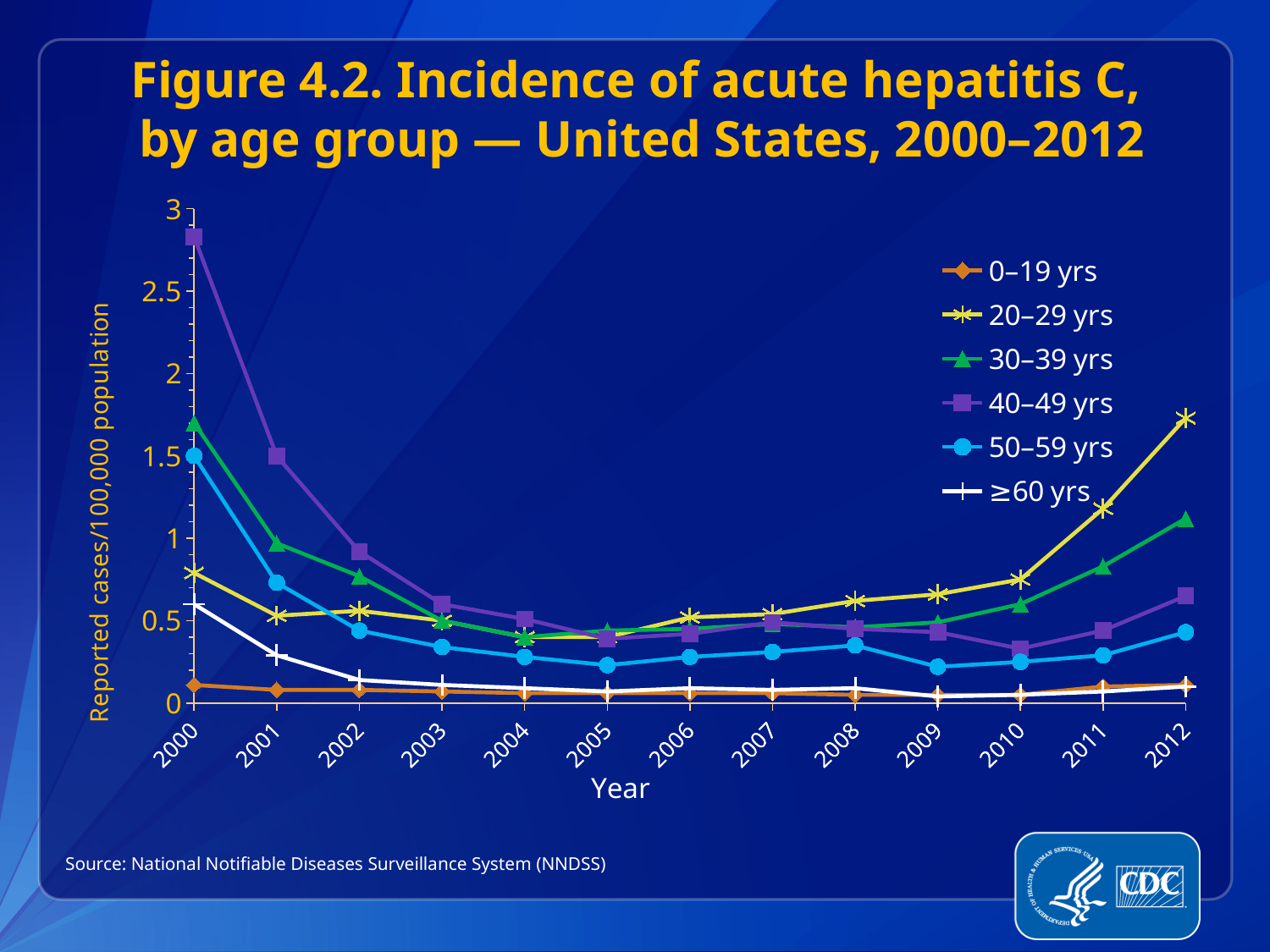
How many age-group series does the legend list? 6 What kind of chart is shown on the slide? line chart Which age group had the highest incidence in 2012? 20–29 yrs Is the value for the 20–29 yrs group in 2012 greater or less than 1.5? greater Does the 20–29 yrs line rise or fall from 2009 to 2012? rise How many years are plotted along the x axis? 13 In 2012, which is larger: the value for 30–39 yrs or for 40–49 yrs? 30–39 yrs Which age group had the highest incidence in 2000? 40–49 yrs Is the value for the 30–39 yrs group in 2000 greater or less than 1.5? greater What is the label on the y axis? Reported cases/100,000 population Is the value for the 40–49 yrs group in 2000 greater or less than 2.5? greater Which age group had the lowest incidence in 2000? 0–19 yrs